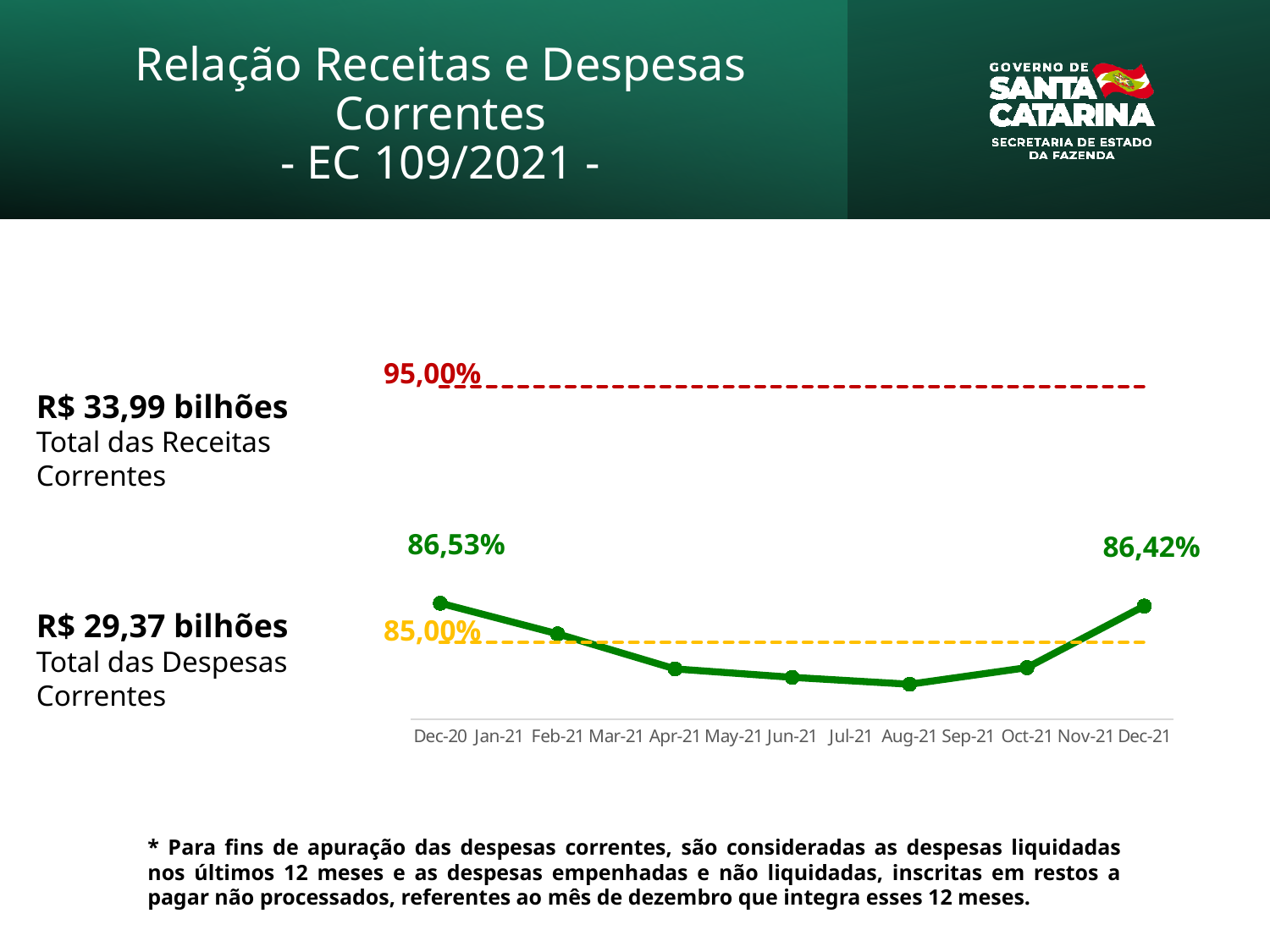
What value does the red dashed reference line mark? 95,00% What is the difference between the Dec-20 value and the Dec-21 value? 0,11 percentage points What is the value plotted for Dec-20? 86,53% How many data points are plotted on the green line? 7 What is the value plotted for Dec-21? 86,42% What kind of chart is shown on the slide? line chart How do the values change from Dec-20 to Aug-21? they fall Is the value for Dec-21 greater or less than 95,00%? less Which is larger, the value for Dec-20 or the value for Dec-21? Dec-20 Which plotted month has the highest value? Dec-20 Is the value for Jun-21 greater or less than 85,00%? less Is the value for Dec-20 greater or less than 85,00%? greater